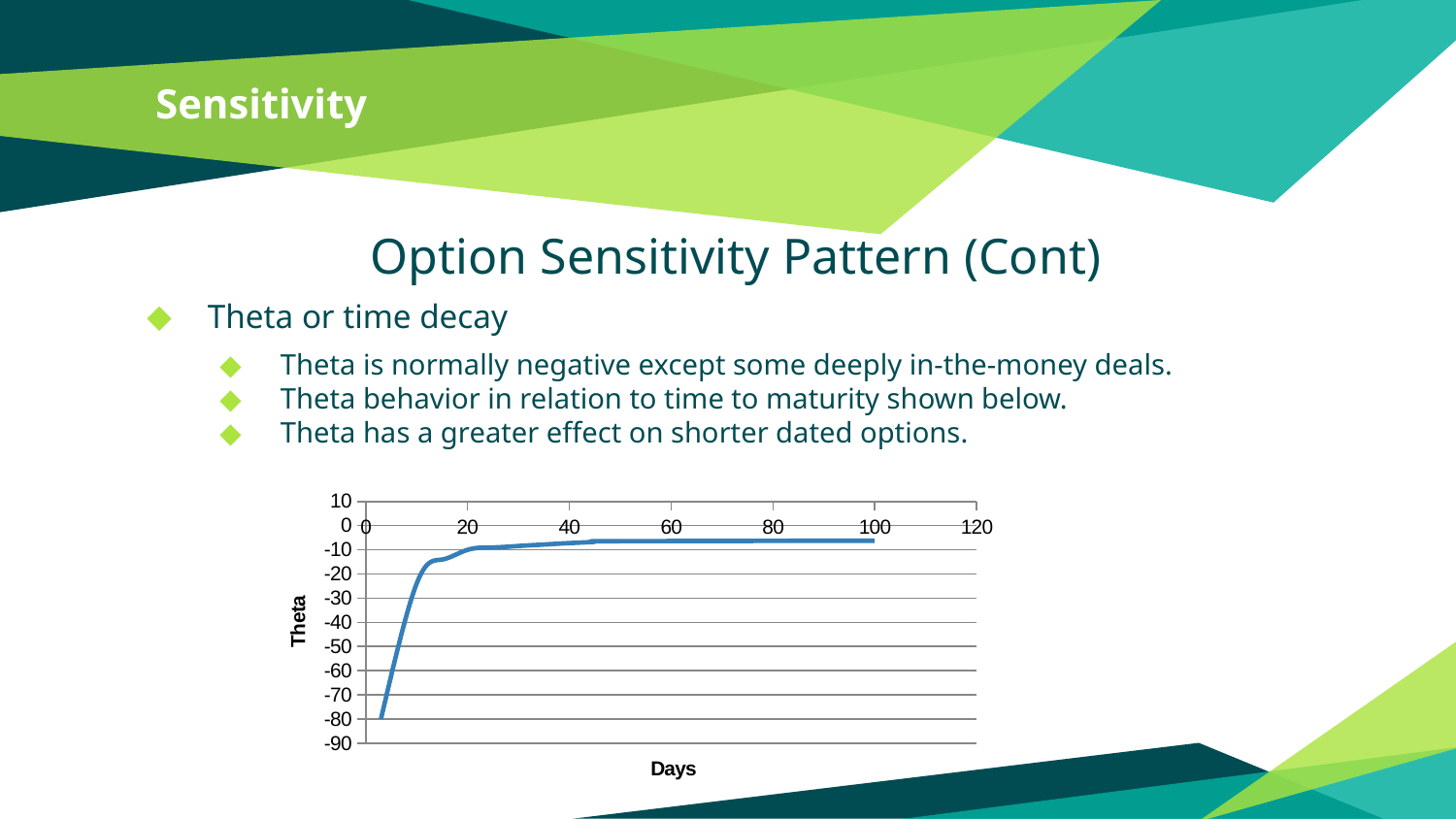
What is the title of the horizontal axis of the chart? Days Is the Theta value at 80 days greater or less than 0? less What is the title of the vertical axis of the chart? Theta Is the Theta value at 100 days greater or less than -10? greater Is the lowest Theta value plotted at the start of the line greater or less than -50? less Does the Theta value rise or fall as Days increase along the x axis? rise What kind of chart is shown on the slide? line chart